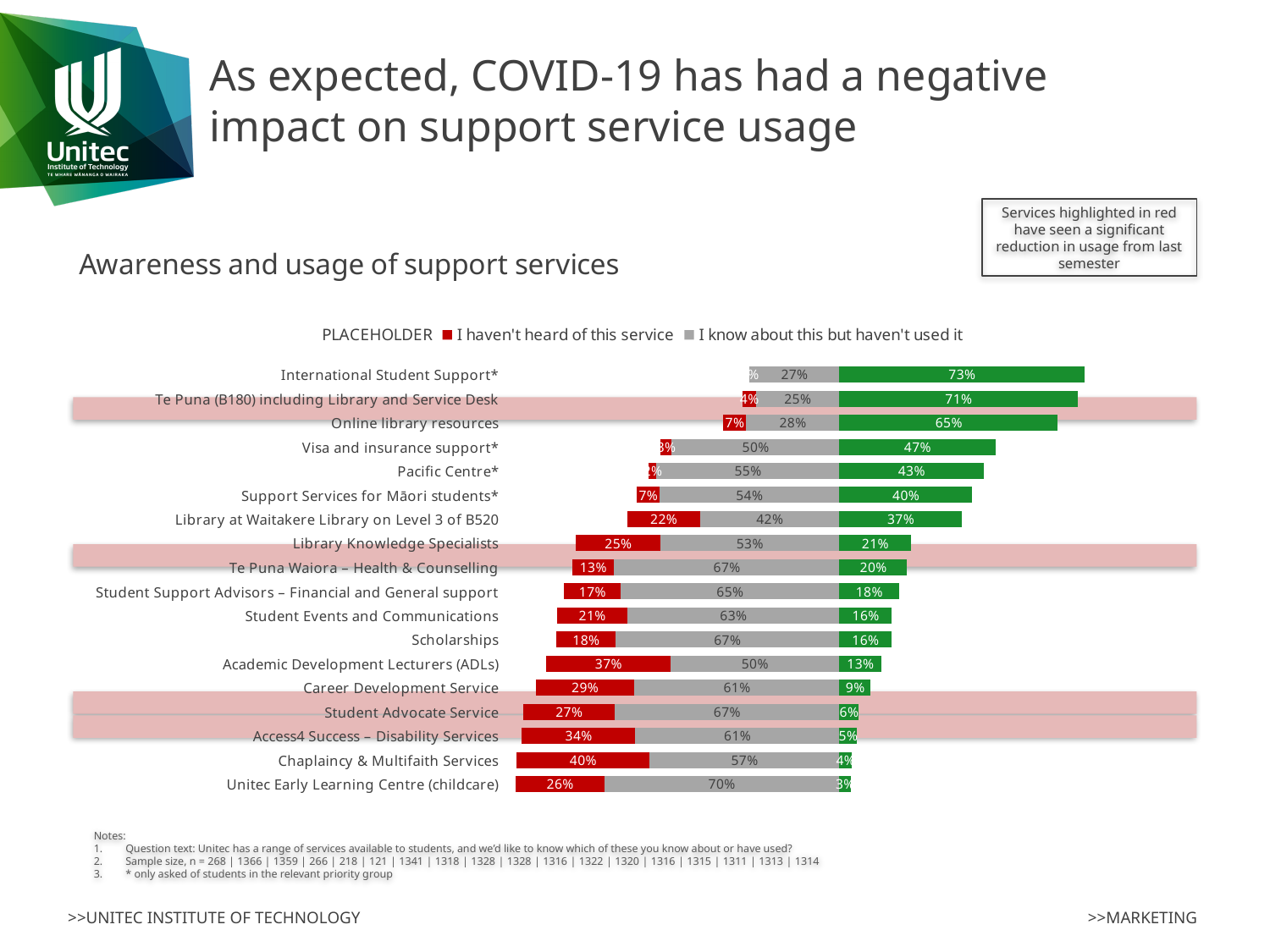
What percentage of respondents said "I know about this but haven't used it" for Scholarships? 67% How many services are listed in the chart? 18 Which service has the lowest percentage for "I know about this but haven't used it"? Te Puna (B180) including Library and Service Desk Which service has the highest percentage for "I haven't heard of this service"? Chaplaincy & Multifaith Services What colour represents "I haven't heard of this service" in the chart? Red Which service has the highest percentage for "I know about this but haven't used it"? Unitec Early Learning Centre (childcare) What percentage of respondents said "I haven't heard of this service" for Chaplaincy & Multifaith Services? 40% What is the value of the green segment for International Student Support*? 73% What percentage of respondents said "I haven't heard of this service" for Library at Waitakere Library on Level 3 of B520? 22% Which has a larger "I haven't heard of this service" percentage: Access4 Success – Disability Services or Student Advocate Service? Access4 Success – Disability Services What is the difference in the "I haven't heard of this service" percentage between Academic Development Lecturers (ADLs) and Career Development Service? 8 percentage points What kind of chart is shown on the slide? Stacked horizontal bar chart